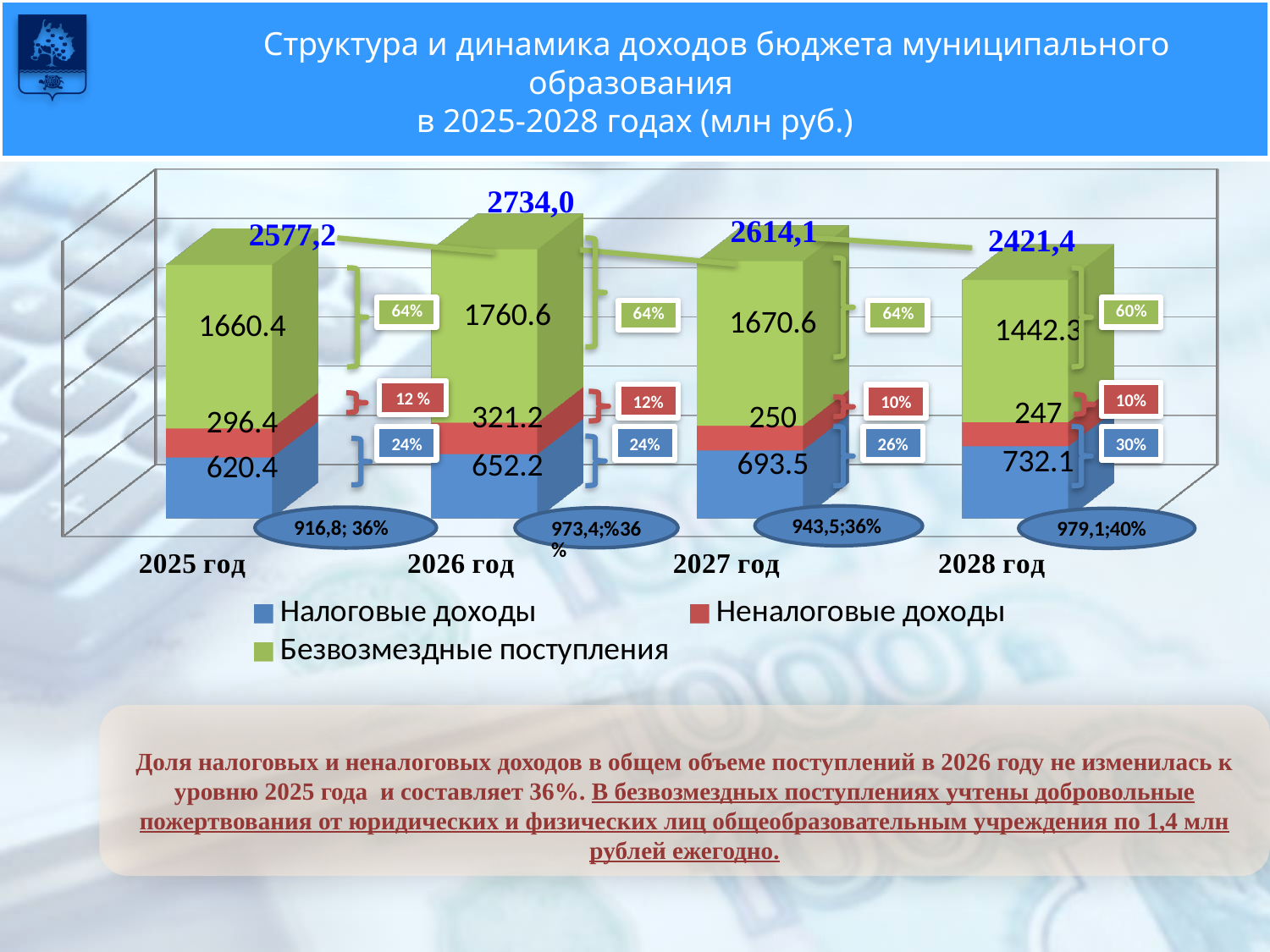
How many series does the legend list? 3 What is the value of Налоговые доходы for 2026 год? 652.2 What is the value of Безвозмездные поступления for 2027 год? 1670.6 What is the difference between Налоговые доходы in 2028 год and 2025 год? 111.7 What type of chart is shown on the slide? Stacked bar chart Do the values of Налоговые доходы rise or fall from 2025 год to 2028 год? Rise How many years (categories) are shown on the x axis? 4 What is the total shown above the bar for 2026 год? 2734,0 Which year has the highest total budget income? 2026 год What is the value of Неналоговые доходы for 2028 год? 247 Which year has the lowest value of Безвозмездные поступления? 2028 год Which is larger: Неналоговые доходы in 2026 год or in 2027 год? 2026 год